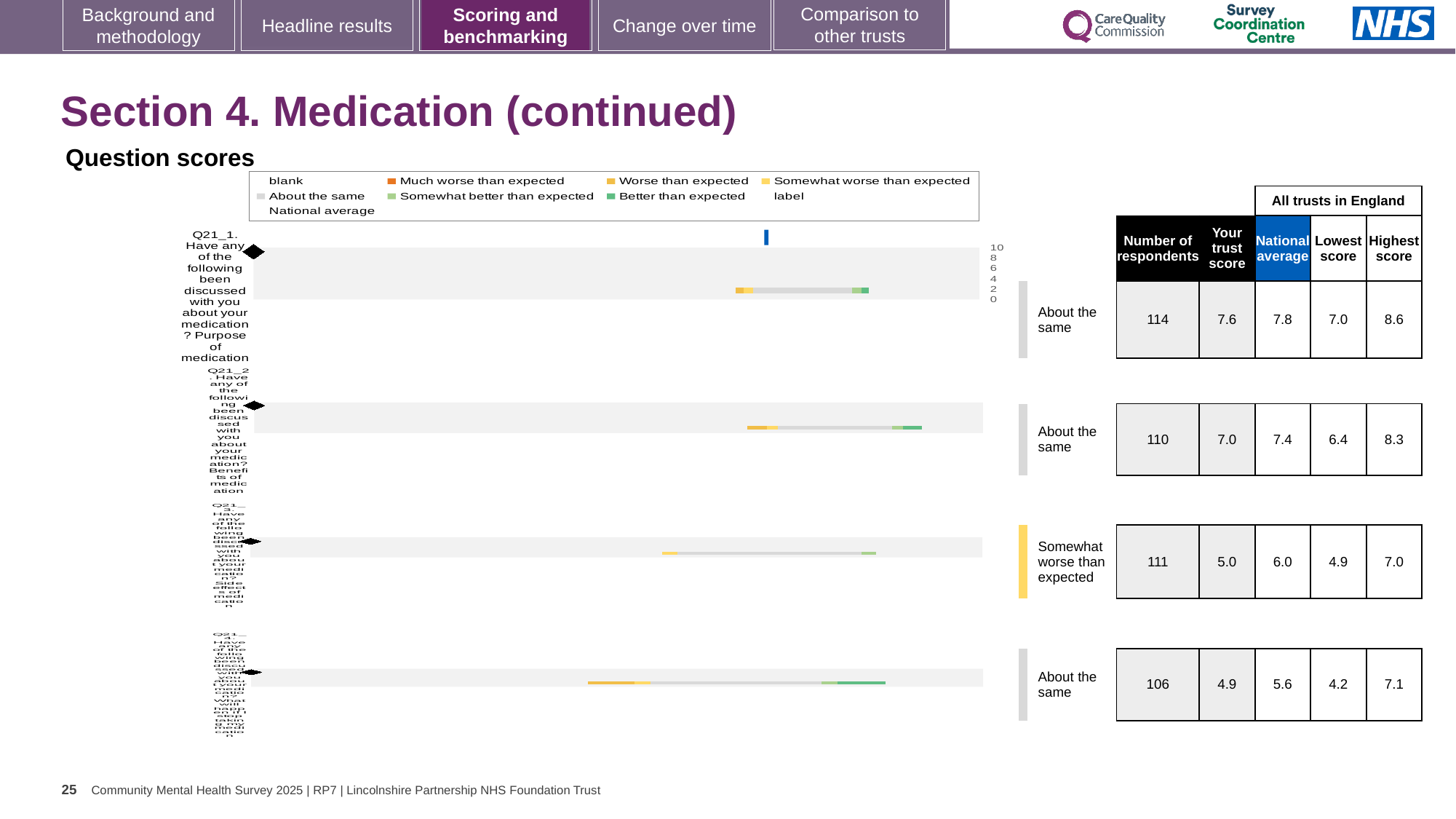
Is the trust score for Q21_2 larger or smaller than the national average for Q21_2? smaller How many question bars are plotted in the chart? 4 How many respondents answered Q21_3 (Side effects of medication)? 111 Which question has the lowest number of respondents? Q21_4 What is the 'Your trust score' for Q21_1 (Purpose of medication)? 7.6 What kind of chart is shown under 'Question scores'? bar chart Which question has the highest 'Your trust score'? Q21_1 What is the national average for Q21_2 (Benefits of medication)? 7.4 What is the highest score among all trusts in England for Q21_4 (What might happen if stop taking medication)? 7.1 Which question is rated 'Somewhat worse than expected'? Q21_3 What is the difference between the national average and the trust score for Q21_3? 1.0 What colour in the legend represents 'Somewhat worse than expected'? yellow